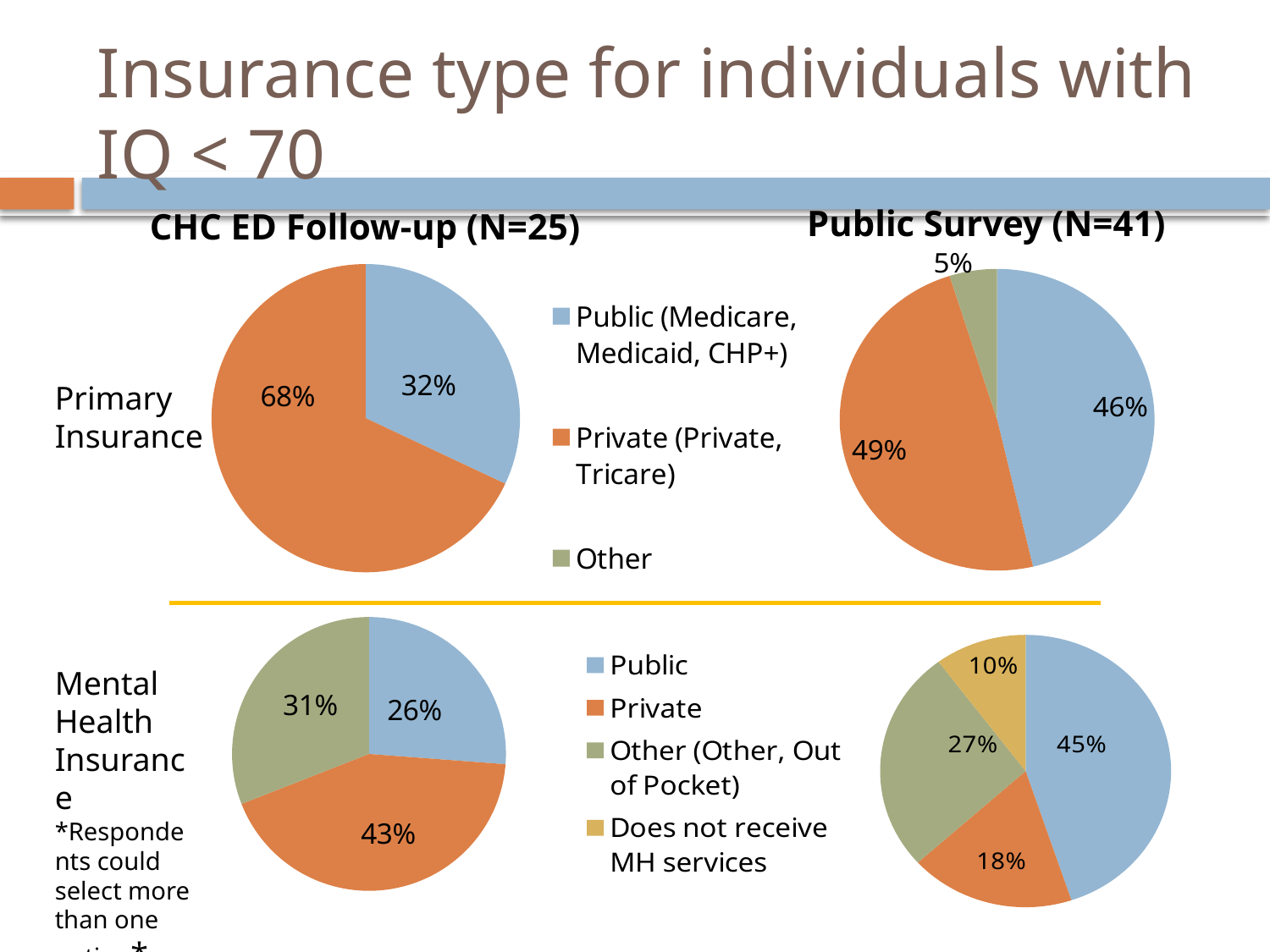
In the Mental Health Insurance pie chart for Public Survey, which is larger: Other (Other, Out of Pocket) or Private? Other (Other, Out of Pocket) In the Mental Health Insurance pie chart for Public Survey, what share is Does not receive MH services? 10% In the Primary Insurance pie chart for CHC ED Follow-up (N=25), what share is Private (Private, Tricare)? 68% In the Primary Insurance pie chart for CHC ED Follow-up (N=25), what share is Public (Medicare, Medicaid, CHP+)? 32% In the Mental Health Insurance pie chart for CHC ED Follow-up, which category has the smallest share? Public What type of chart is used for the Primary Insurance data on this slide? Pie chart In the Primary Insurance pie chart for Public Survey (N=41), which category has the largest share? Private (Private, Tricare) In the Primary Insurance pie chart for Public Survey (N=41), what share is Other? 5% In the Mental Health Insurance pie chart for CHC ED Follow-up, what share is Private? 43% In the Primary Insurance pie chart for Public Survey (N=41), what is the difference between the Private and Public shares? 3% How many entries does the legend for the Mental Health Insurance charts list? 4 How many slices does the Mental Health Insurance pie chart for Public Survey have? 4